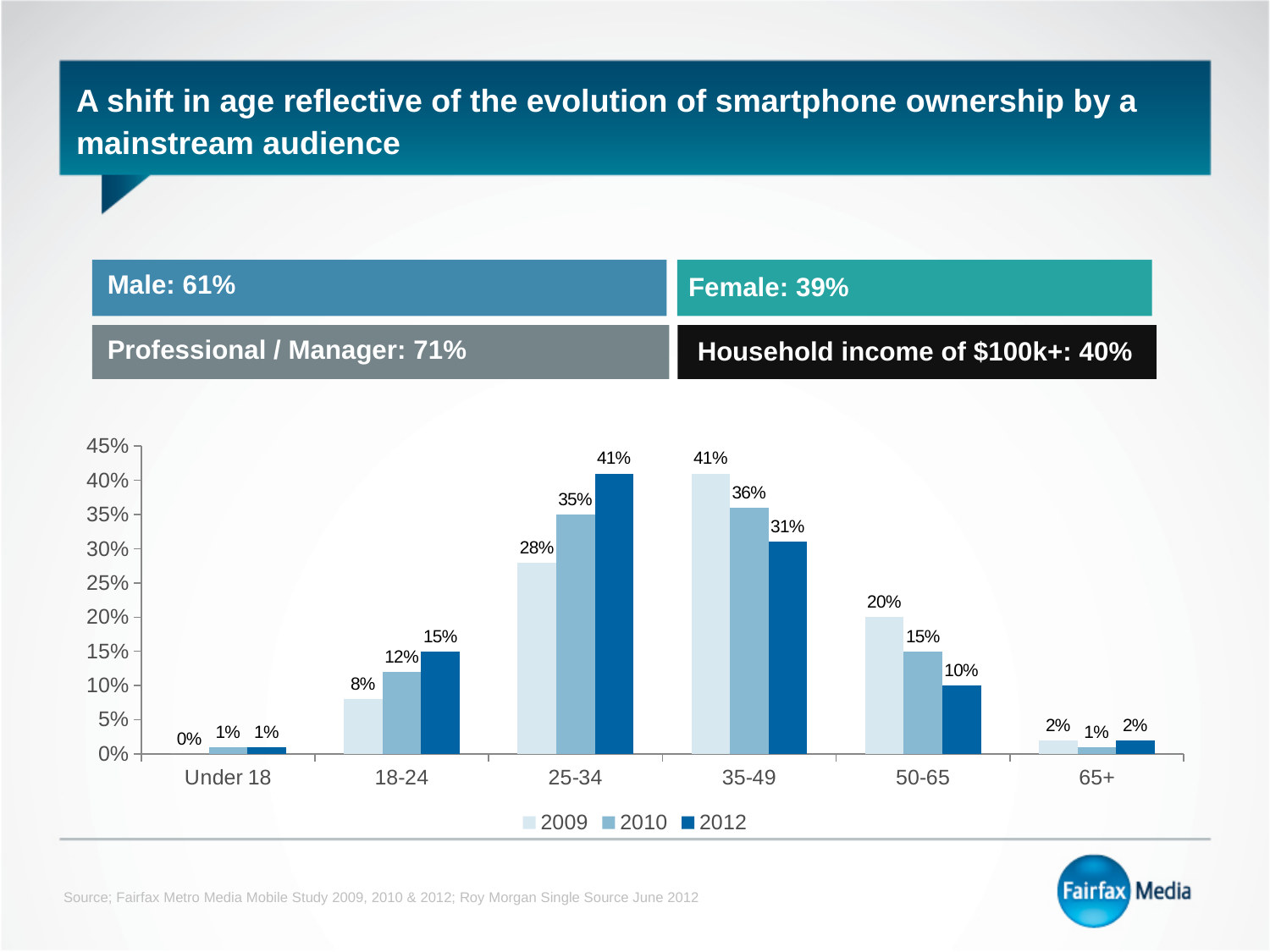
Which is larger for the 35-49 age group: the 2009 value or the 2012 value? 2009 Which age group has the lowest value in 2009? Under 18 How many age groups are shown on the x axis? 6 Do the values for the 50-65 age group rise or fall from 2009 to 2012? Fall Which age group has the highest value in 2012? 25-34 Which years are listed in the chart legend? 2009, 2010, 2012 What is the value for the 25-34 age group in 2012? 41% What kind of chart is shown on the slide? Bar chart How many series does the legend list? 3 What is the difference between the 2012 and 2009 values for the 25-34 age group? 13% What is the value for the 35-49 age group in 2009? 41% What is the value for the 50-65 age group in 2010? 15%